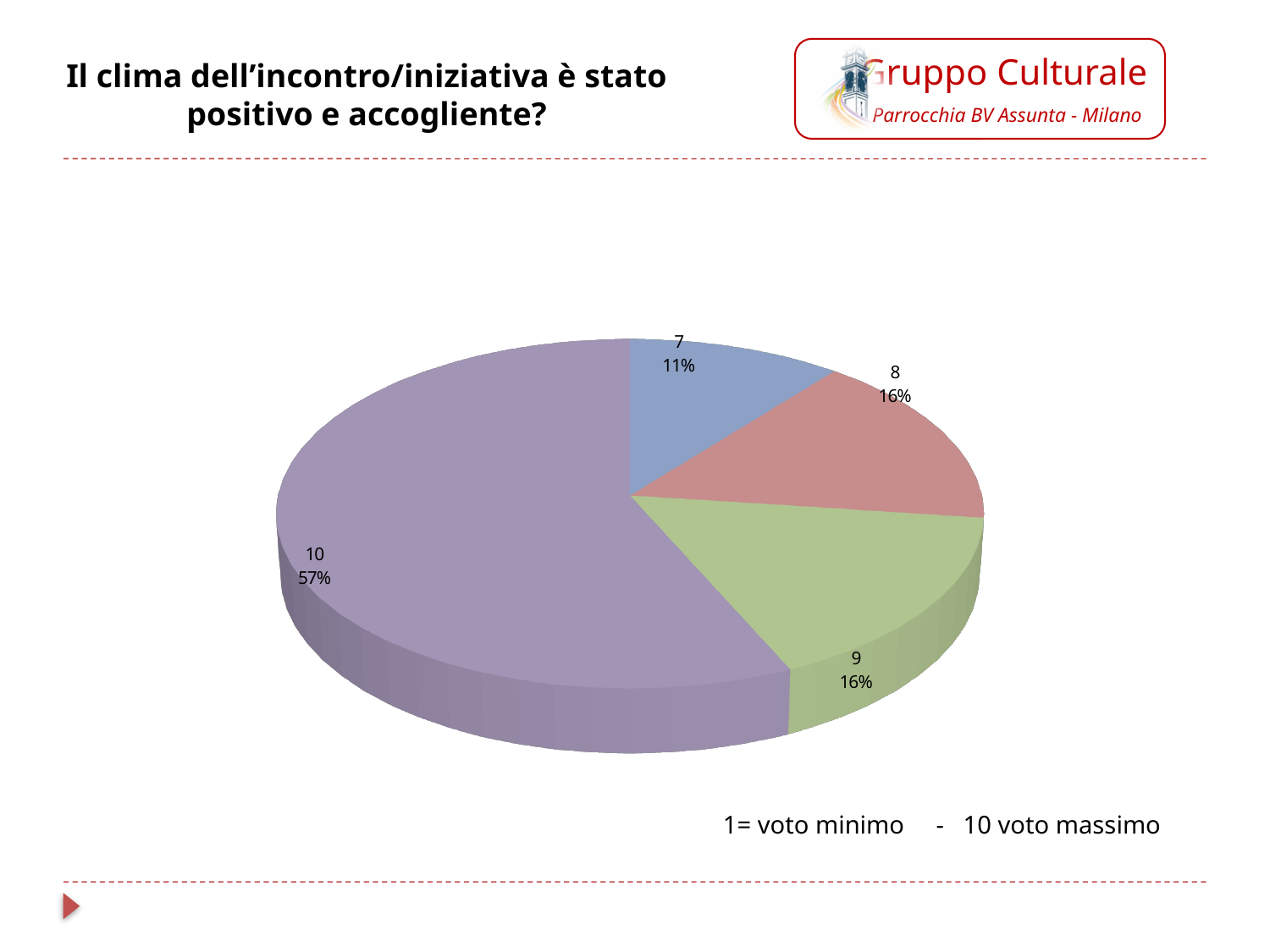
How many slices does the pie chart have? 4 What share of the pie does the slice for vote 7 represent? 11% What share of the pie does the slice for vote 9 represent? 16% What is the difference in percentage points between the slice for vote 10 and the slice for vote 7? 46 What share of the pie does the slice for vote 10 represent? 57% What is the combined share of the slices for vote 8 and vote 9? 32% Which vote has the smallest slice of the pie? 7 Which vote has the largest slice of the pie? 10 Which slice is larger, the one for vote 10 or the one for vote 9? 10 What colour is the slice for vote 10? purple What kind of chart is shown on the slide? pie chart